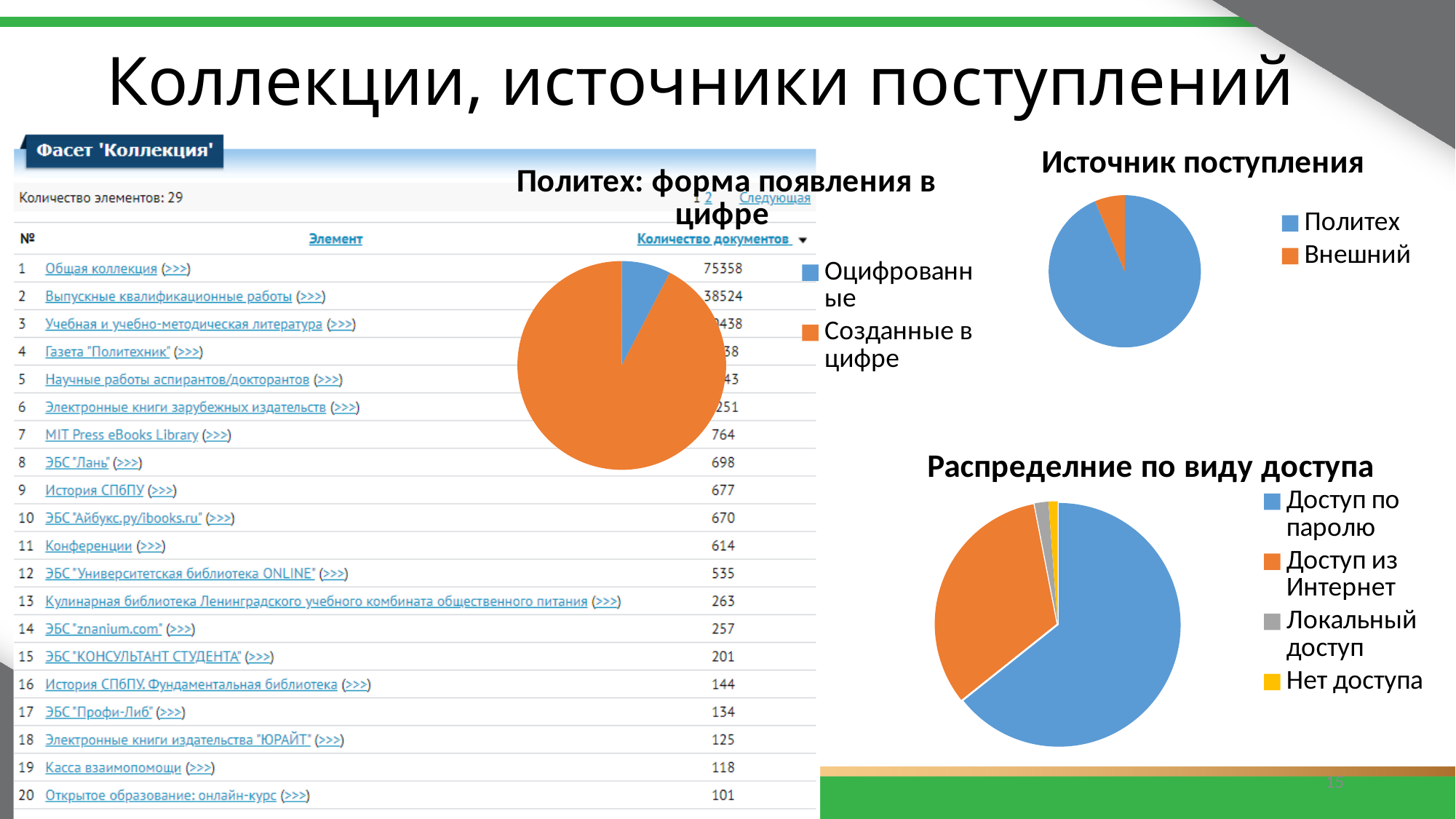
In the 'Распределние по виду доступа' chart, which is larger: Доступ из Интернет or Локальный доступ? Доступ из Интернет In the 'Распределние по виду доступа' chart, which category has the smallest slice? Нет доступа What colour is the 'Внешний' slice in the 'Источник поступления' chart? orange In the 'Распределние по виду доступа' chart, which category has the largest slice? Доступ по паролю How many categories does the legend of the 'Распределние по виду доступа' chart list? 4 In the 'Источник поступления' chart, which is larger: Политех or Внешний? Политех What kind of chart is the 'Политех: форма появления в цифре' chart? pie chart In the 'Источник поступления' chart, which category has the largest slice? Политех In the 'Политех: форма появления в цифре' chart, which category has the largest slice? Созданные в цифре How many categories does the legend of the 'Политех: форма появления в цифре' chart list? 2 In the 'Политех: форма появления в цифре' chart, which category has the smallest slice? Оцифрованные What kind of chart is the 'Распределние по виду доступа' chart? pie chart